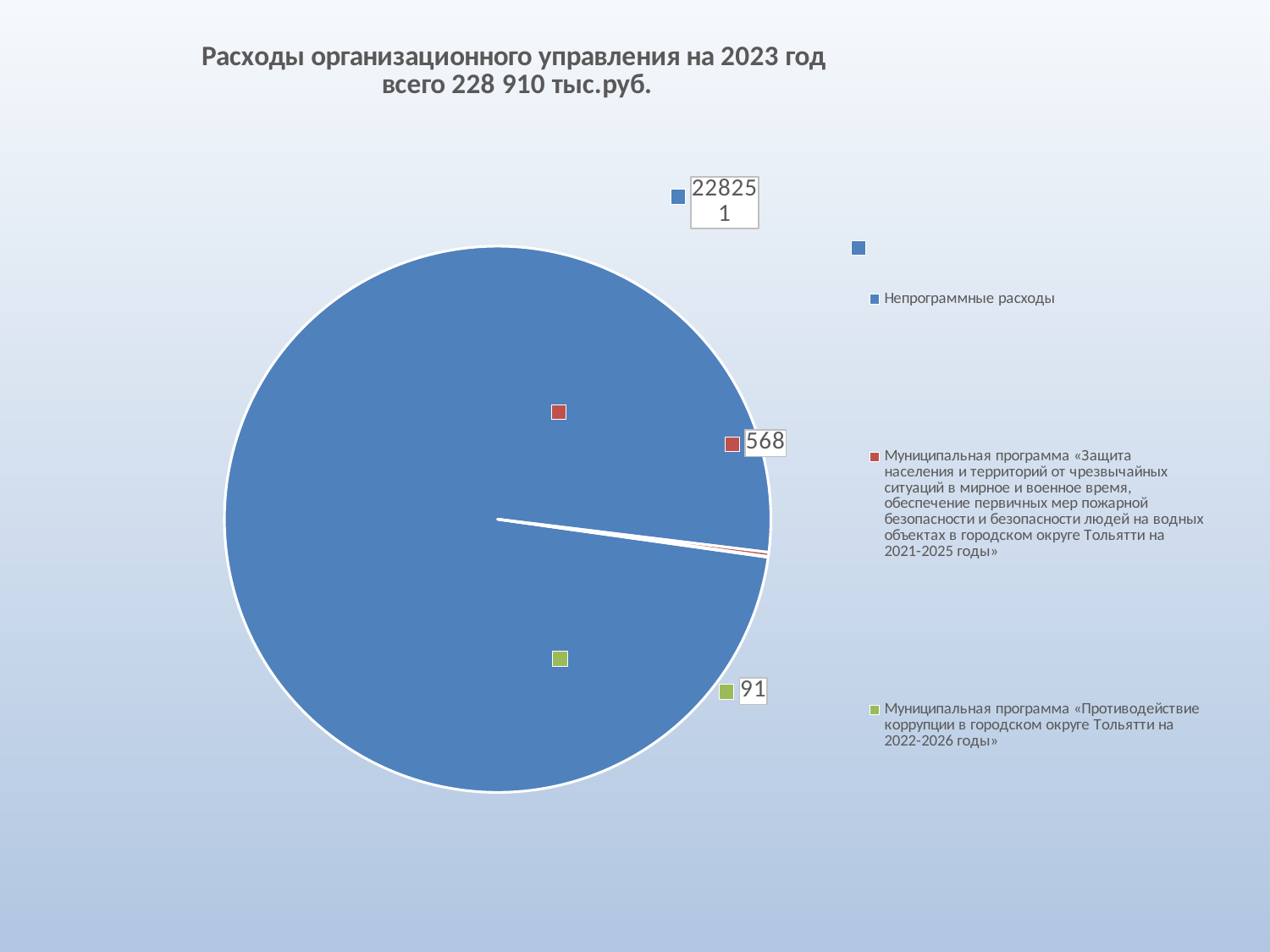
What is the value for the Муниципальная программа «Противодействие коррупции в городском округе Тольятти на 2022-2026 годы» slice? 91 Which category has the smallest slice of the pie? Муниципальная программа «Противодействие коррупции в городском округе Тольятти на 2022-2026 годы» What colour is the slice for Непрограммные расходы? blue Which is larger: the value for the «Защита населения...» programme or the «Противодействие коррупции...» programme? Муниципальная программа «Защита населения...» How many slices does the pie chart have? 3 What is the value for Непрограммные расходы? 228251 What is the value for the Муниципальная программа «Защита населения и территорий от чрезвычайных ситуаций...» slice? 568 What is the difference between the value for the «Защита населения...» programme and the «Противодействие коррупции...» programme? 477 What type of chart is shown on the slide? pie chart Which category has the largest slice of the pie? Непрограммные расходы What is the total of all three slices in the pie chart? 228910